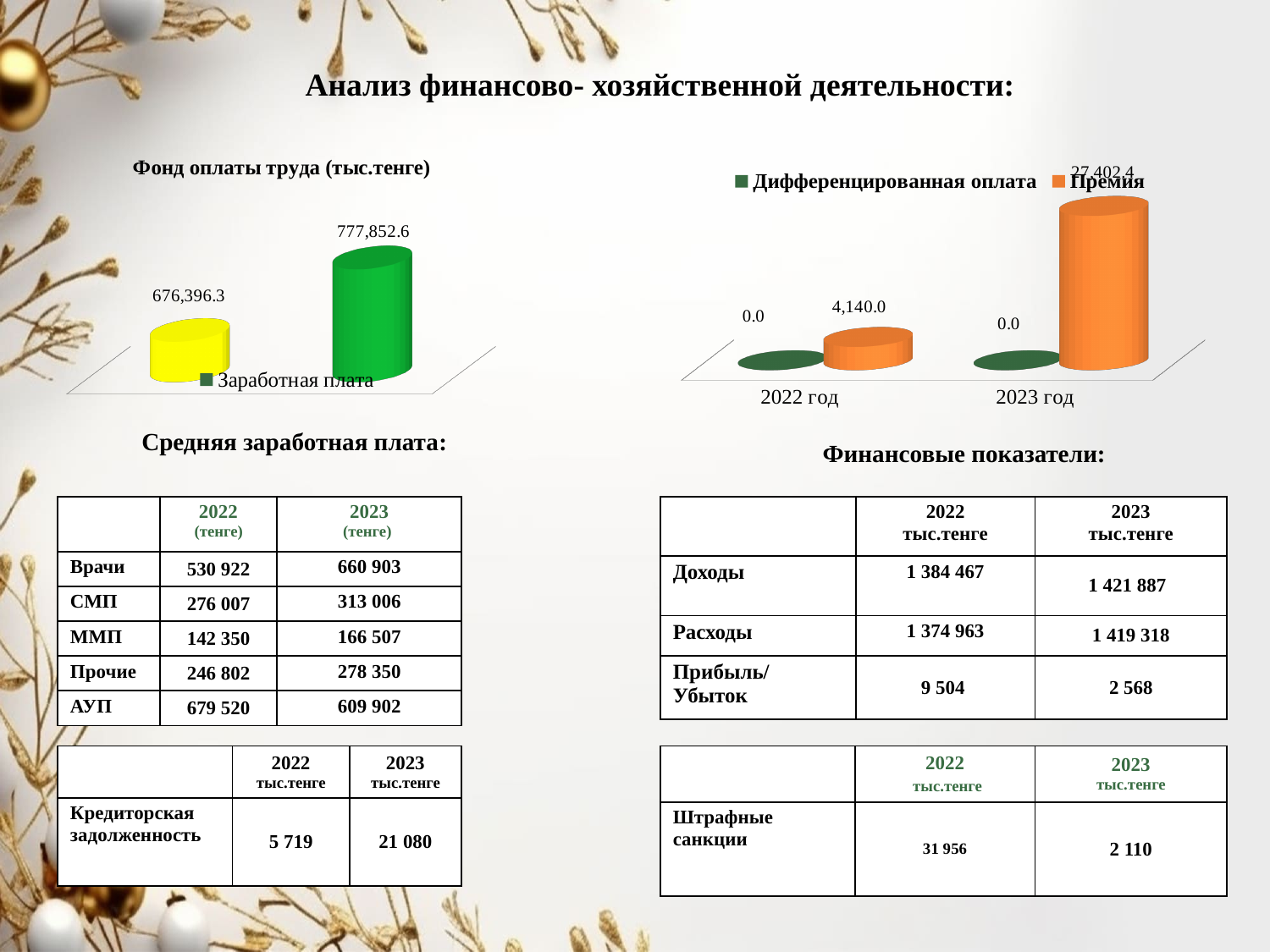
In the chart on the right with the legend 'Дифференцированная оплата' and 'Премия', what is the value of Дифференцированная оплата for 2022 год? 0.0 In the chart titled 'Фонд оплаты труда (тыс.тенге)', what is the legend entry? Заработная плата In the chart titled 'Фонд оплаты труда (тыс.тенге)', what is the difference between the green bar and the yellow bar? 101,456.3 In the chart titled 'Фонд оплаты труда (тыс.тенге)', what value is labelled on the green bar? 777,852.6 In the chart titled 'Фонд оплаты труда (тыс.тенге)', what value is labelled on the yellow bar? 676,396.3 In the chart titled 'Фонд оплаты труда (тыс.тенге)', which bar is taller, the yellow one or the green one? the green one In the chart on the right with the legend 'Дифференцированная оплата' and 'Премия', does the Премия value rise or fall from 2022 год to 2023 год? rise In the chart on the right with the legend 'Дифференцированная оплата' and 'Премия', what is the value of Премия for 2022 год? 4,140.0 What kind of chart is the one titled 'Фонд оплаты труда (тыс.тенге)'? bar chart In the chart on the right with the legend 'Дифференцированная оплата' and 'Премия', how many series does the legend list? 2 In the chart on the right with the legend 'Дифференцированная оплата' and 'Премия', what is the value of Премия for 2023 год? 27,402.4 In the chart on the right with the legend 'Дифференцированная оплата' and 'Премия', by how much did Премия increase from 2022 год to 2023 год? 23,262.4